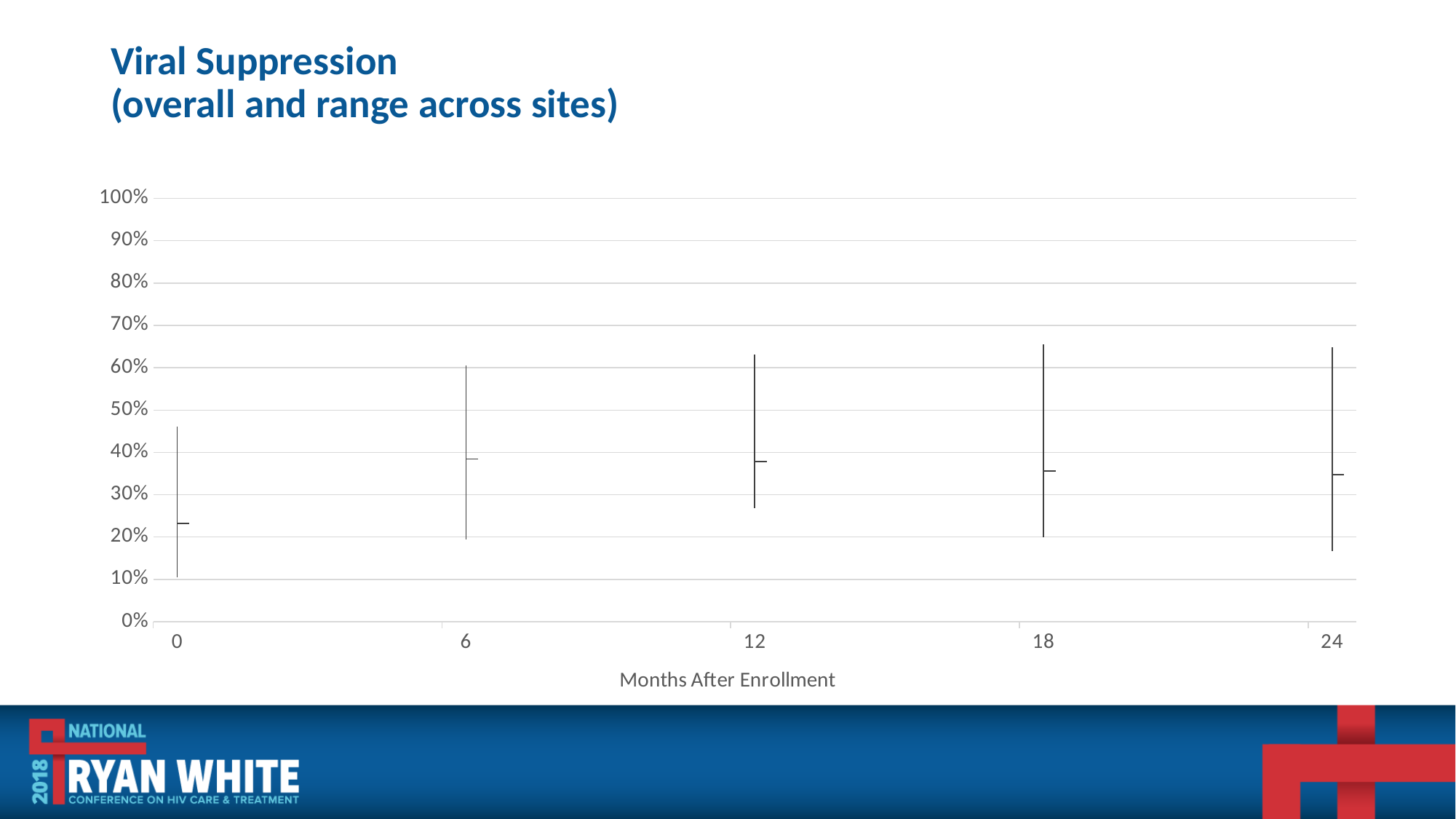
Is the overall viral suppression value at 0 months greater or less than 30%? less What is the label of the x axis? Months After Enrollment Is the top of the range at 18 months greater or less than 60%? greater Does the overall viral suppression value rise or fall from 0 months to 6 months? rise How many time points are plotted on the x axis? 5 At which time point is the overall viral suppression value lowest? 0 months What is the title of the chart? Viral Suppression (overall and range across sites) Is the overall viral suppression value at 6 months greater or less than 30%? greater Which has the higher overall viral suppression value, 0 months or 6 months? 6 months